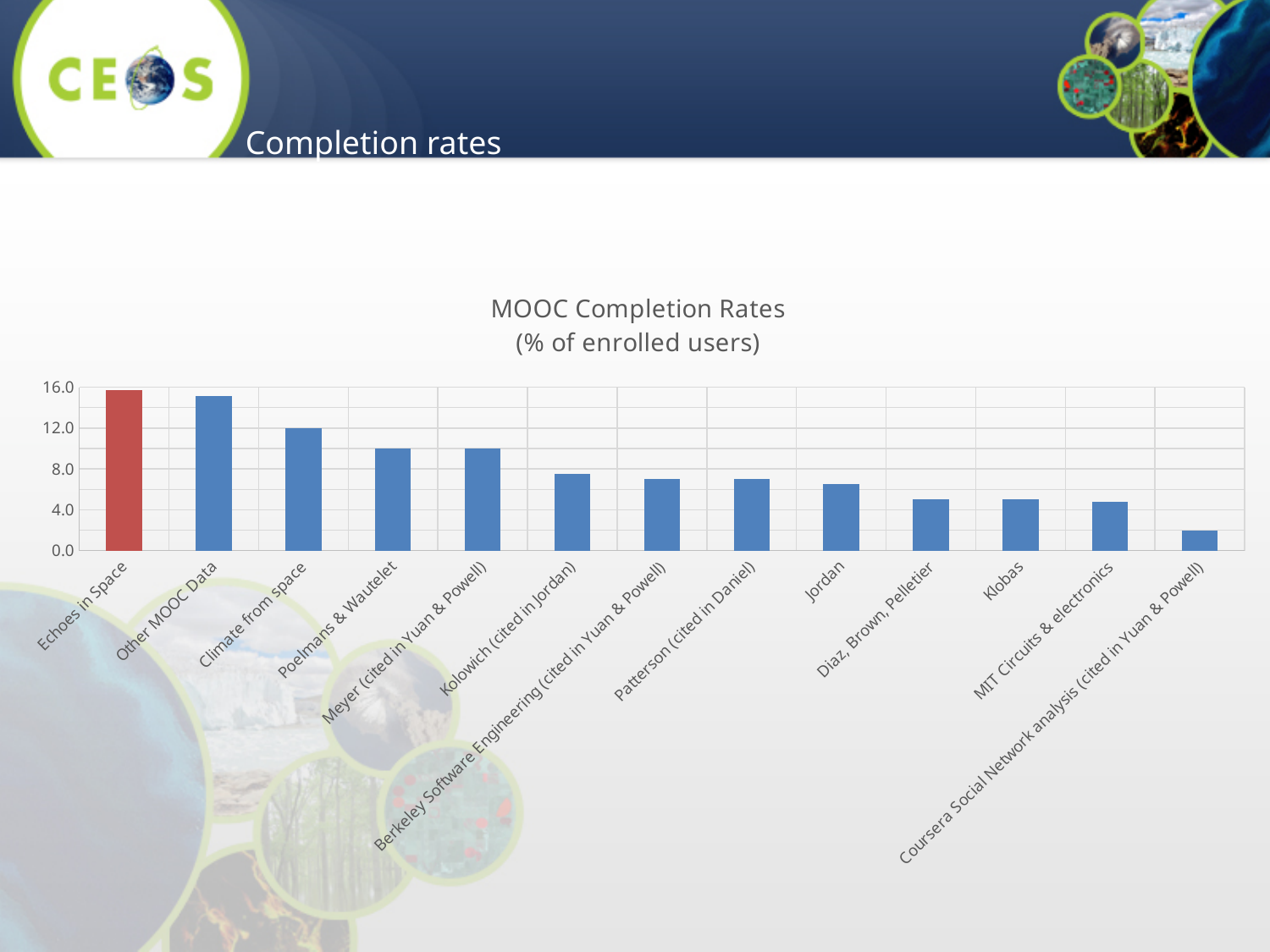
Which category has the highest completion rate? Echoes in Space Which is larger, the value for Climate from space or the value for Klobas? Climate from space Is the value for Coursera Social Network analysis (cited in Yuan & Powell) greater or less than 4.0? less Do the values generally rise or fall from left to right along the x axis? fall Is the value for Other MOOC Data greater or less than 12.0? greater Which bar is coloured differently (red) from the others? Echoes in Space Is the value for Jordan greater or less than 8.0? less What kind of chart is shown on the slide? bar chart How many categories (bars) are shown in the chart? 13 What is the title of the chart? MOOC Completion Rates (% of enrolled users) Which category has the lowest completion rate? Coursera Social Network analysis (cited in Yuan & Powell)